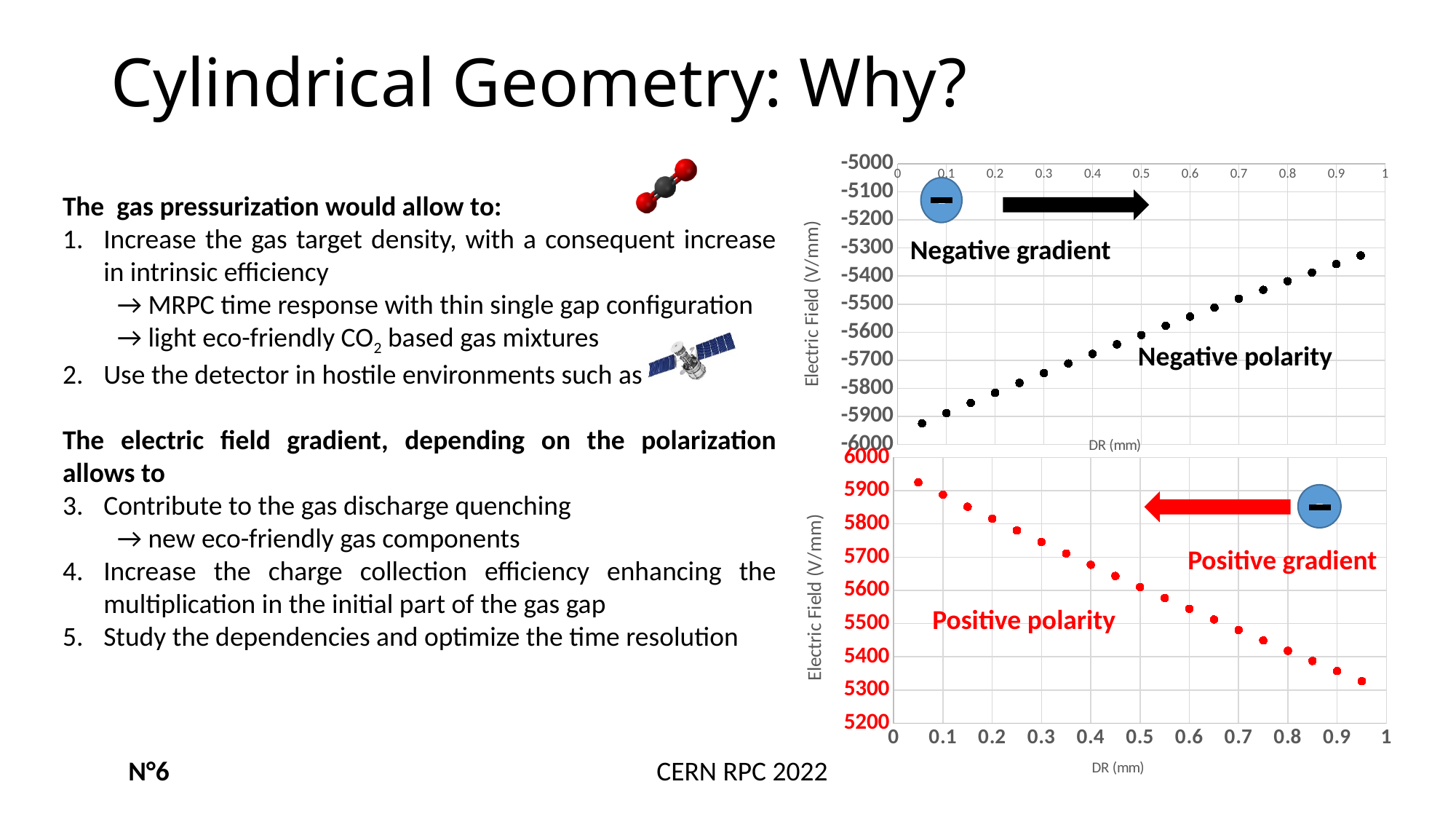
What kind of chart is the bottom chart labelled 'Positive polarity'? scatter chart In the top chart (Negative polarity), is the electric field value at DR = 0.95 mm greater or less than -5400? greater In the bottom chart (Positive polarity), is the electric field value at DR = 0.95 mm greater or less than 5400? less In the top chart (Negative polarity), is the electric field value at DR = 0.5 mm greater or less than -5700? greater What kind of chart is the top chart labelled 'Negative polarity'? scatter chart In the bottom chart (Positive polarity), do the electric field values rise or fall as DR increases from 0 to 1 mm? fall What is the x-axis label of the top chart (Negative polarity)? DR (mm) In the top chart (Negative polarity), do the electric field values rise or fall as DR increases from 0 to 1 mm? rise What is the y-axis label of the bottom chart (Positive polarity)? Electric Field (V/mm)